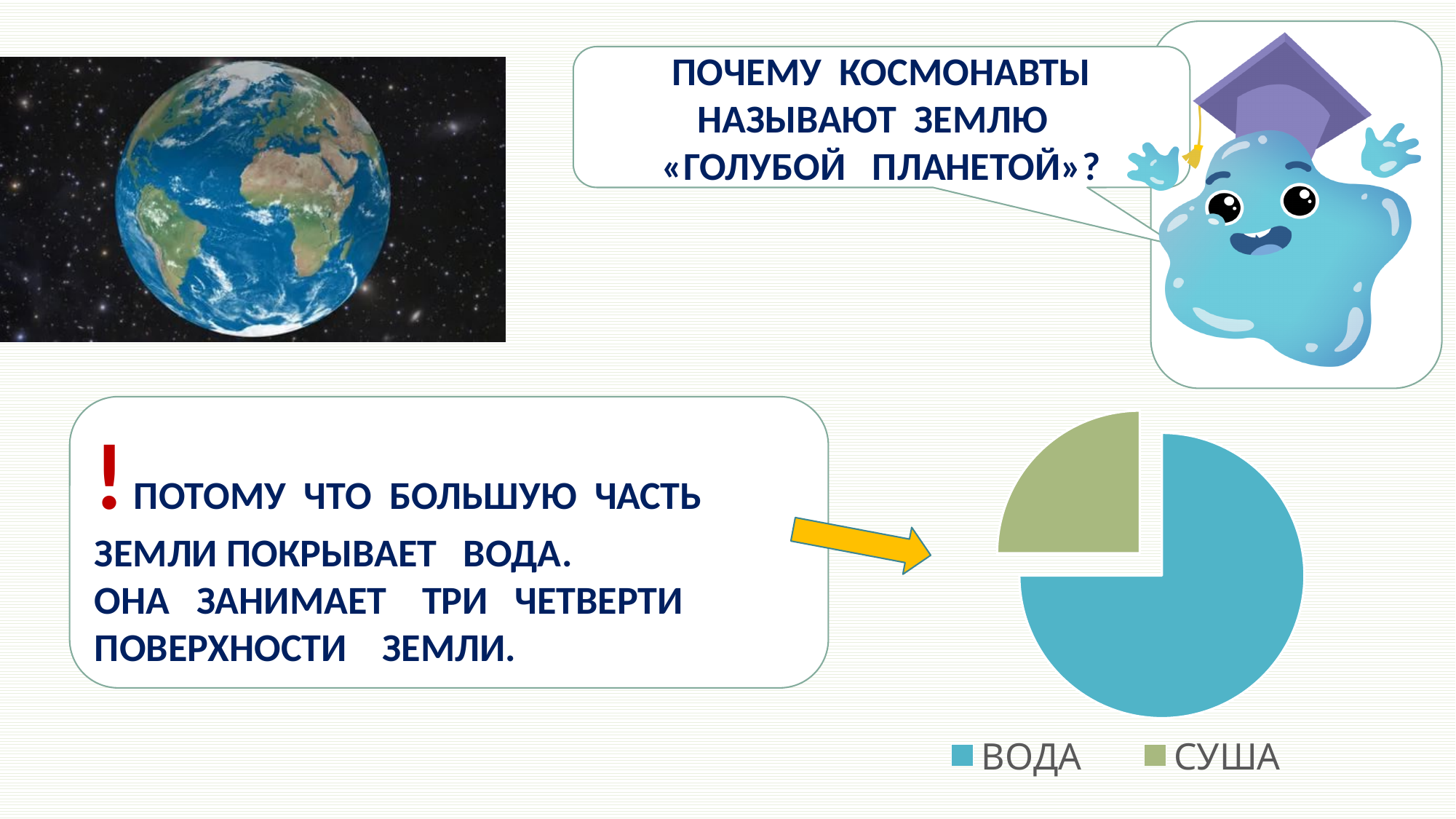
Which category has the largest slice in the pie chart? ВОДА Which category has the smallest slice in the pie chart? СУША Which slice is larger in the pie chart, ВОДА or СУША? ВОДА What colour is the ВОДА slice in the pie chart? blue What kind of chart is shown on the slide? pie chart How many entries does the legend of the pie chart list? 2 How many slices does the pie chart have? 2 What are the two legend entries of the pie chart? ВОДА and СУША